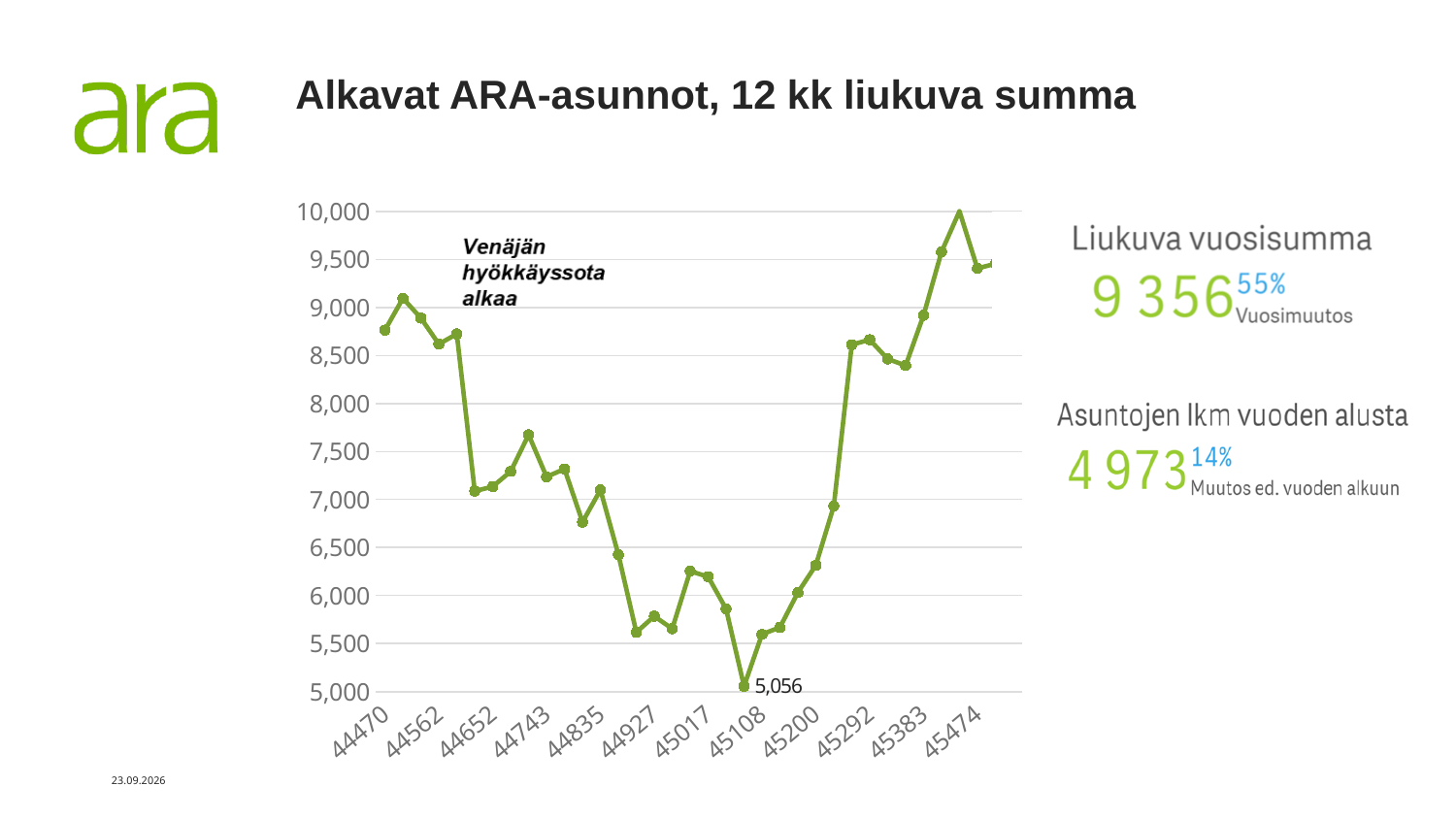
Is the value at 45474 greater or less than 9,000? greater How many labels are shown on the x axis? 12 Is the value at 44927 greater or less than 6,000? less Does the line rise or fall between 45108 and 45292? rise What is the value of the labelled lowest point on the line? 5,056 Is the highest point on the line greater or less than 9,500? greater Does the line rise or fall between 44562 and 44652? fall What is the title of the chart? Alkavat ARA-asunnot, 12 kk liukuva summa Which is larger, the value at 44470 or the value at 45474? 45474 What kind of chart is shown on the slide? line chart